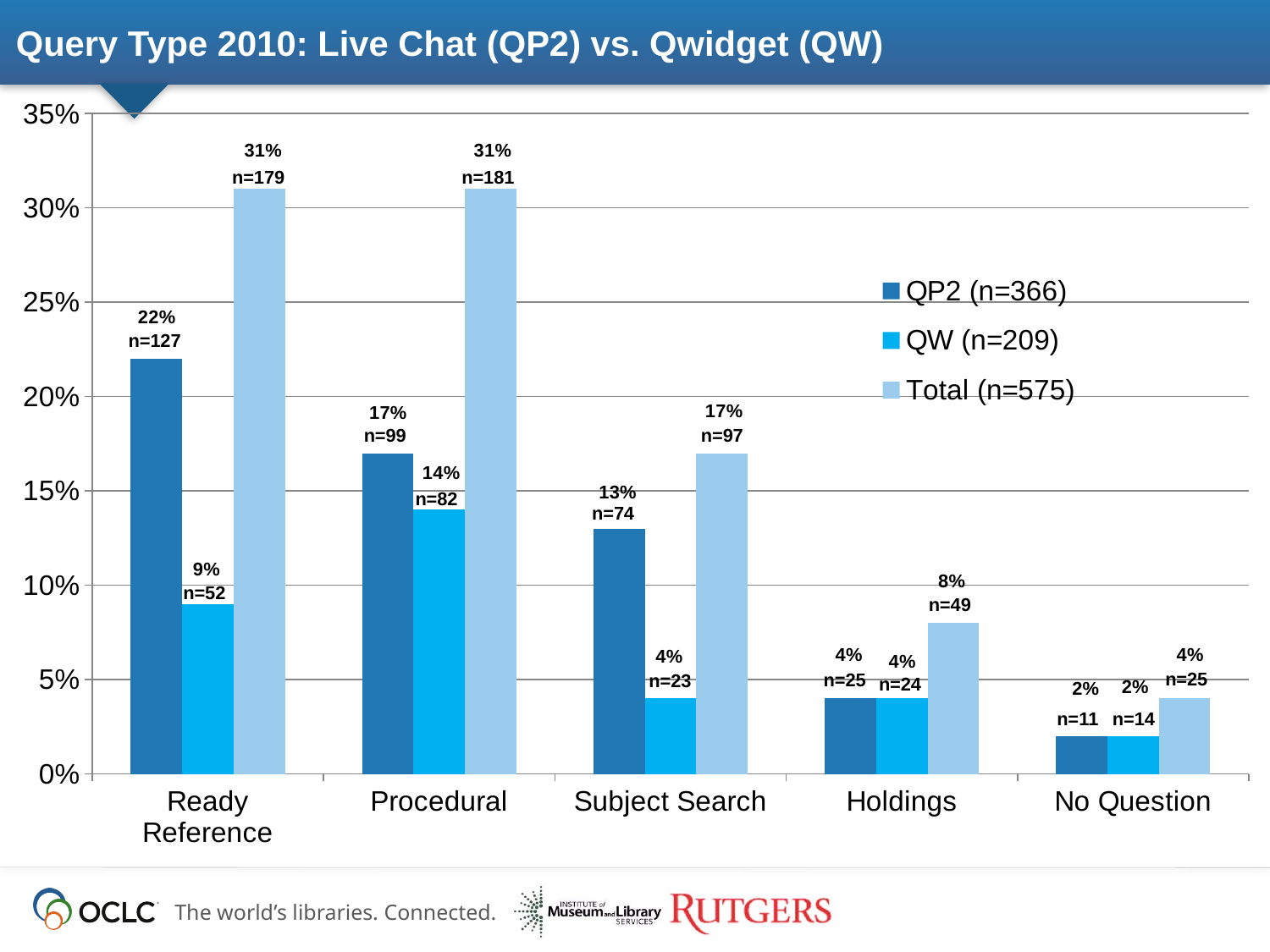
Which is larger for Subject Search, the QP2 (n=366) value or the QW (n=209) value? QP2 (n=366) What kind of chart is shown on the slide? Bar chart Which category has the highest QP2 (n=366) value? Ready Reference How many categories are shown on the x axis? 5 What is the difference between the QP2 (n=366) and QW (n=209) values for Ready Reference? 13% What is the title of the chart? Query Type 2010: Live Chat (QP2) vs. Qwidget (QW) Which category has the lowest QW (n=209) value? No Question What is the QW (n=209) value for Procedural? 14% How many series does the legend list? 3 What is the Total (n=575) value for Holdings? 8% What is the n count shown for the QW (n=209) bar in Subject Search? n=23 What is the QP2 (n=366) value for Ready Reference? 22%